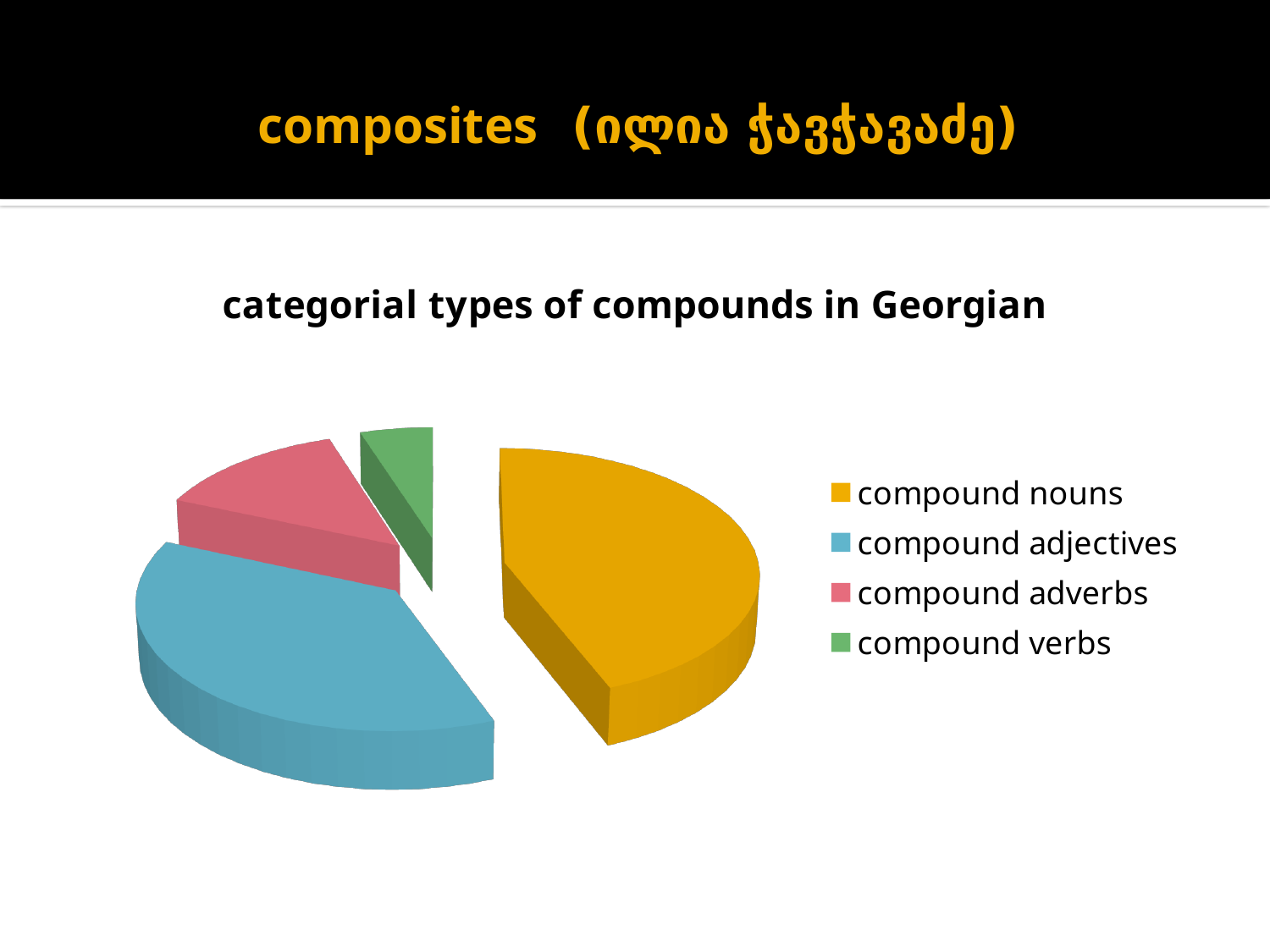
Which slice is larger, compound adverbs or compound verbs? compound adverbs What is the title of the chart? categorial types of compounds in Georgian Which category has the largest slice of the pie? compound nouns Which slice is larger, compound nouns or compound adverbs? compound nouns Which slice is larger, compound adjectives or compound verbs? compound adjectives How many categories does the pie chart show? 4 How many entries does the legend list? 4 Which category has the smallest slice of the pie? compound verbs Which colour represents compound adjectives in the pie chart? blue What kind of chart is shown on the slide? pie chart